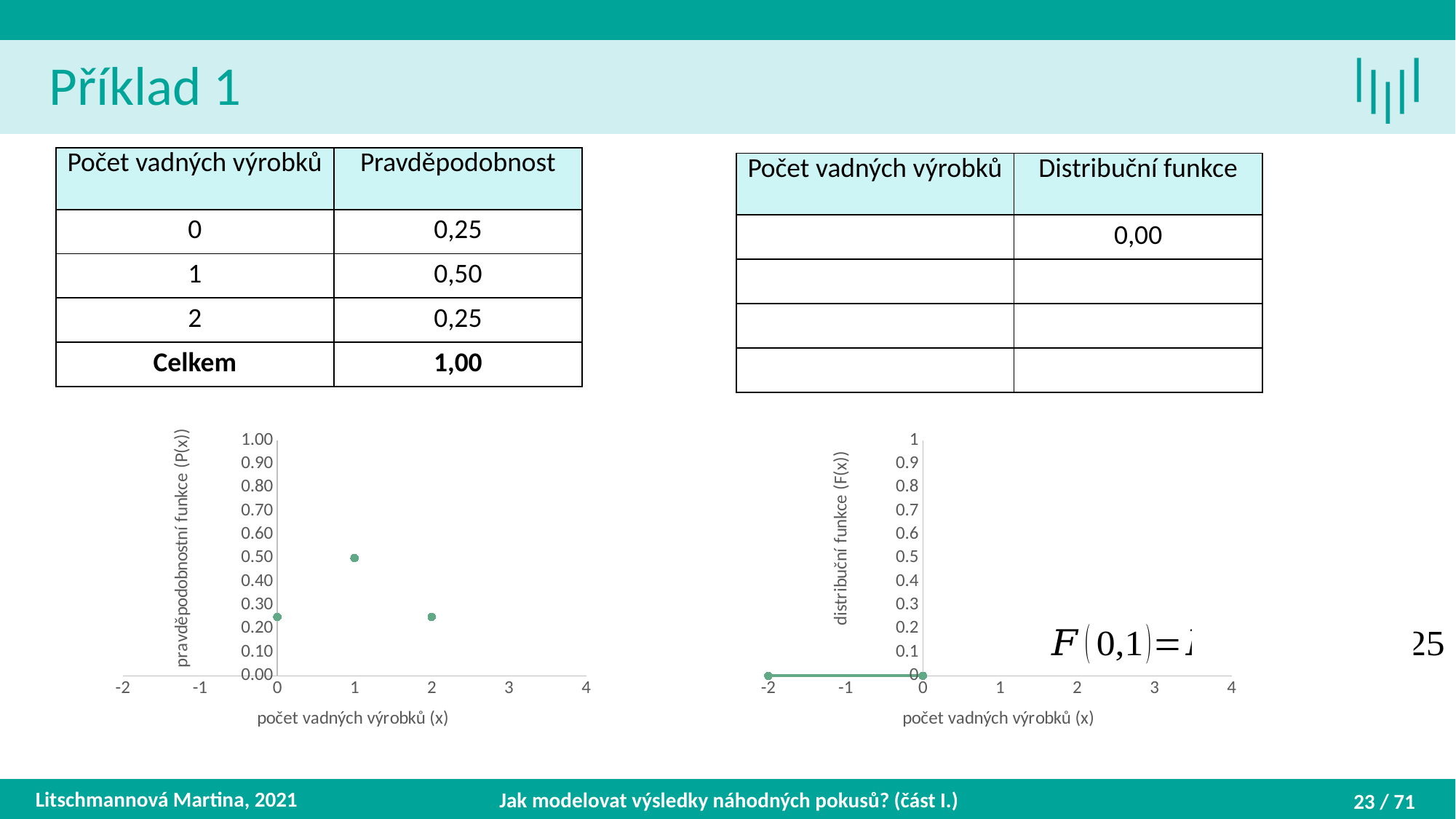
In the left chart, at which value of x is the probability function highest? 1 What is the x-axis title of the left chart? počet vadných výrobků (x) In the left chart, is the value at x = 2 greater or less than 0.20? greater In the left chart, does the value rise or fall from x = 1 to x = 2? fall In the right chart, what is the value of the distribution function at x = -2? 0 How many data points are plotted in the left chart? 3 What is the y-axis title of the right chart? distribuční funkce (F(x)) In the left chart, is the value at x = 0 greater or less than 0.30? less In the left chart, which has the larger value: x = 1 or x = 2? x = 1 In the right chart, does the plotted line rise, fall or stay flat between x = -2 and x = 0? stay flat In the left chart, what is the value of the probability function at x = 1? 0.50 What kind of chart is the left chart? scatter chart